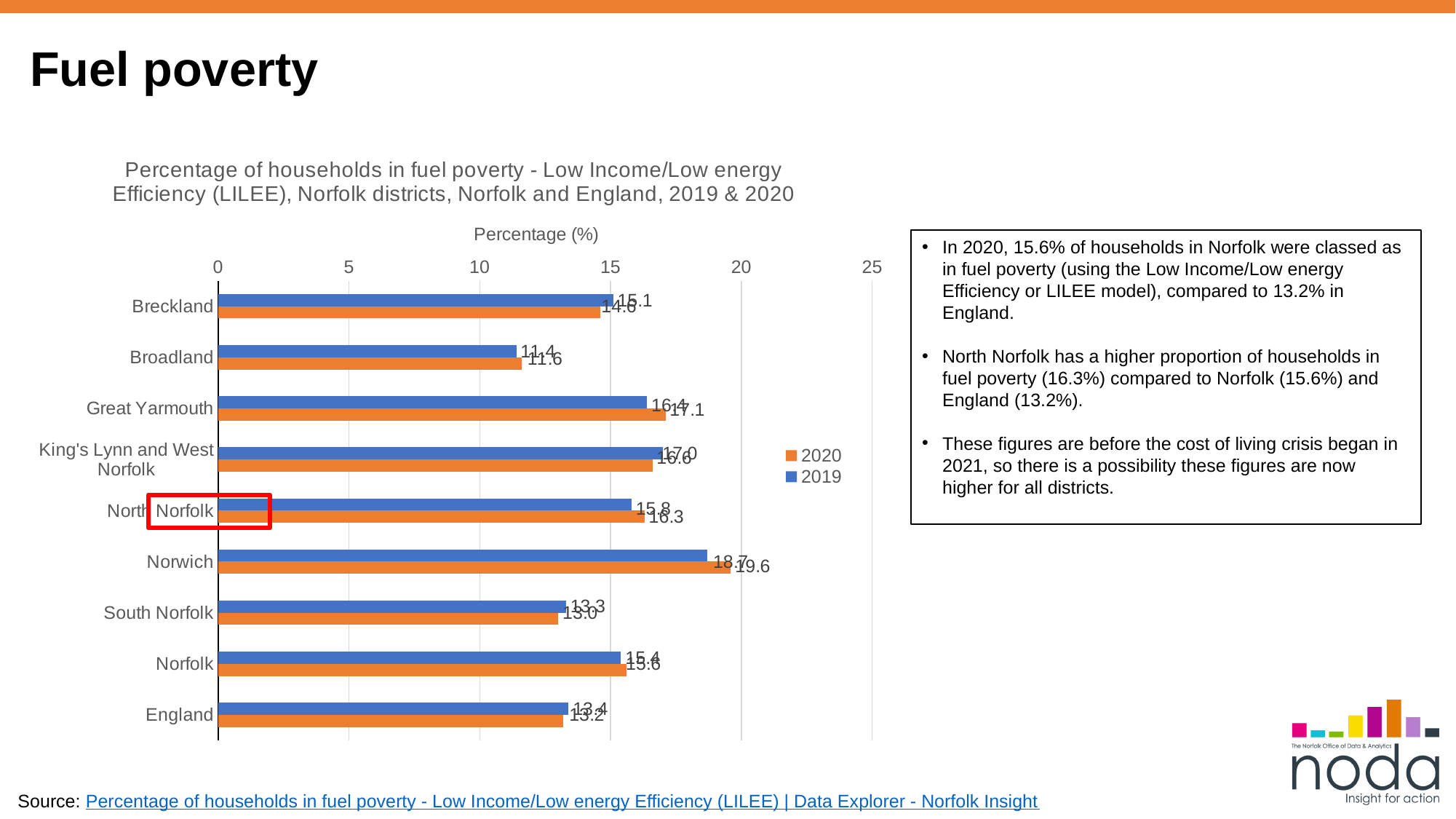
Is the 2019 value for Broadland greater or less than 15? less What is the difference between the 2020 values for North Norfolk and England? 3.1 What is the 2020 value for North Norfolk? 16.3 What is the 2020 value for Norfolk? 15.6 Which has the larger 2020 value, Great Yarmouth or Breckland? Great Yarmouth How many areas (categories) are plotted on the chart? 9 Which area has the lowest 2020 value? Broadland How many series does the chart legend list? 2 What is the 2020 value for England? 13.2 Which area has the highest 2020 value? Norwich What is the 2020 value for Norwich? 19.6 What kind of chart is shown on the slide? Bar chart